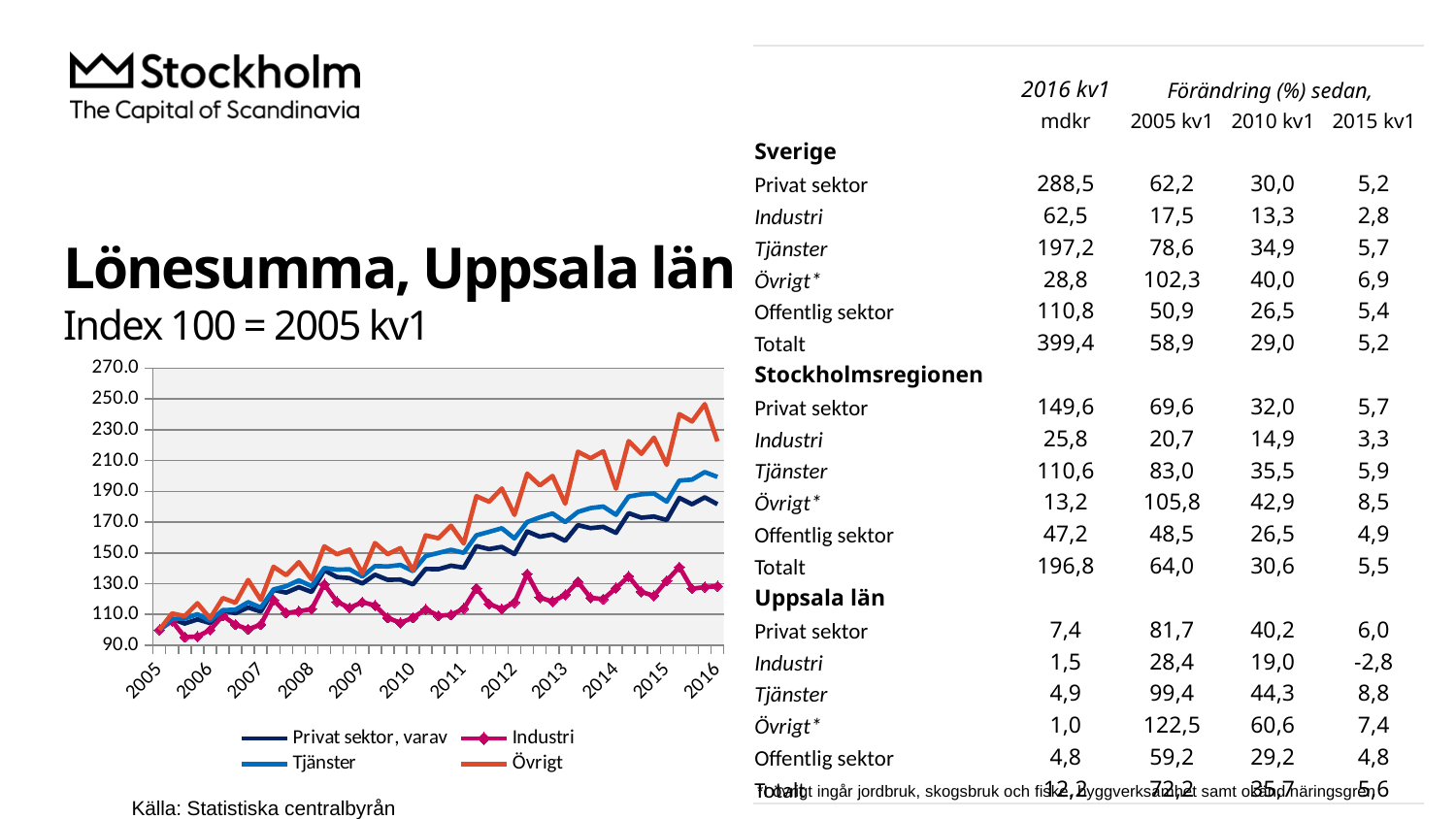
Is the value for Tjänster at the end of 2016 greater or less than 170? greater What is the index base stated under the chart title? Index 100 = 2005 kv1 What kind of chart is shown on the slide? line chart Which series has the highest value at the end of the chart in 2016? Övrigt Does the Övrigt series generally rise or fall from 2005 to 2016? rise How many series does the chart legend list? 4 Which series has the lowest value at the end of the chart in 2016? Industri How many year labels are shown on the x axis of the chart? 12 What is the title of the chart? Lönesumma, Uppsala län Is the value for Övrigt at the end of 2016 greater or less than 210? greater Is the value for Industri at the end of 2016 greater or less than 150? less In 2016, which series is higher, Tjänster or Industri? Tjänster